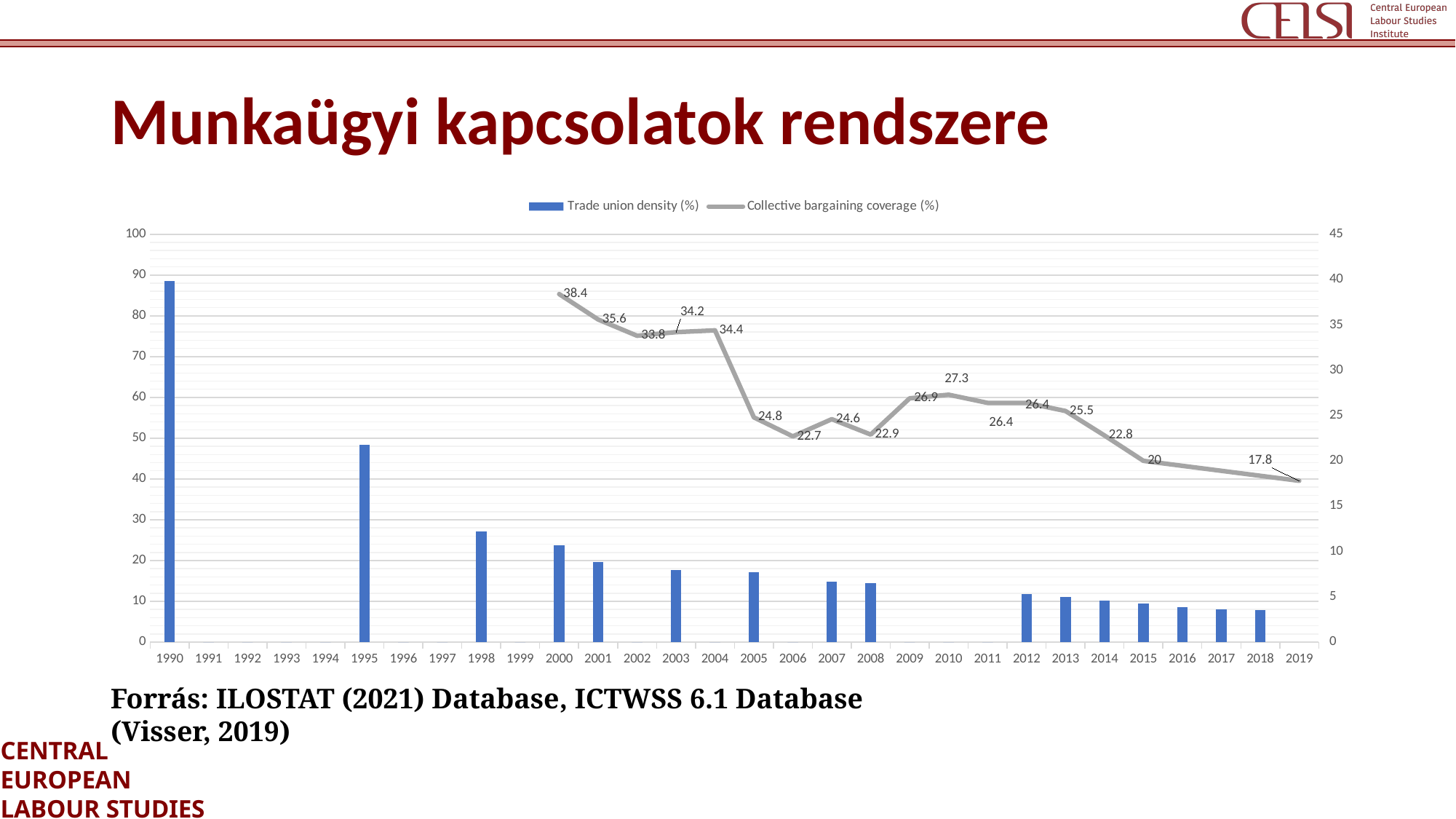
Does the Collective bargaining coverage (%) line generally rise or fall from 2000 to 2019? fall How many series does the legend list? 2 In which year is the Collective bargaining coverage (%) line at its highest labelled value? 2000 Is the Trade union density (%) value for 1995 greater or less than 50? less What is the Collective bargaining coverage (%) value for 2010? 27.3 Is the Trade union density (%) value for 2018 greater or less than 10? less In which year is the Trade union density (%) bar the tallest? 1990 What is the difference between the Collective bargaining coverage (%) values for 2004 and 2005? 9.6 What kind of chart is shown on the slide? Combined bar and line chart Which is larger, the Collective bargaining coverage (%) value for 2003 or for 2005? 2003 What is the Collective bargaining coverage (%) value for 2015? 20 What is the Collective bargaining coverage (%) value for 2000? 38.4